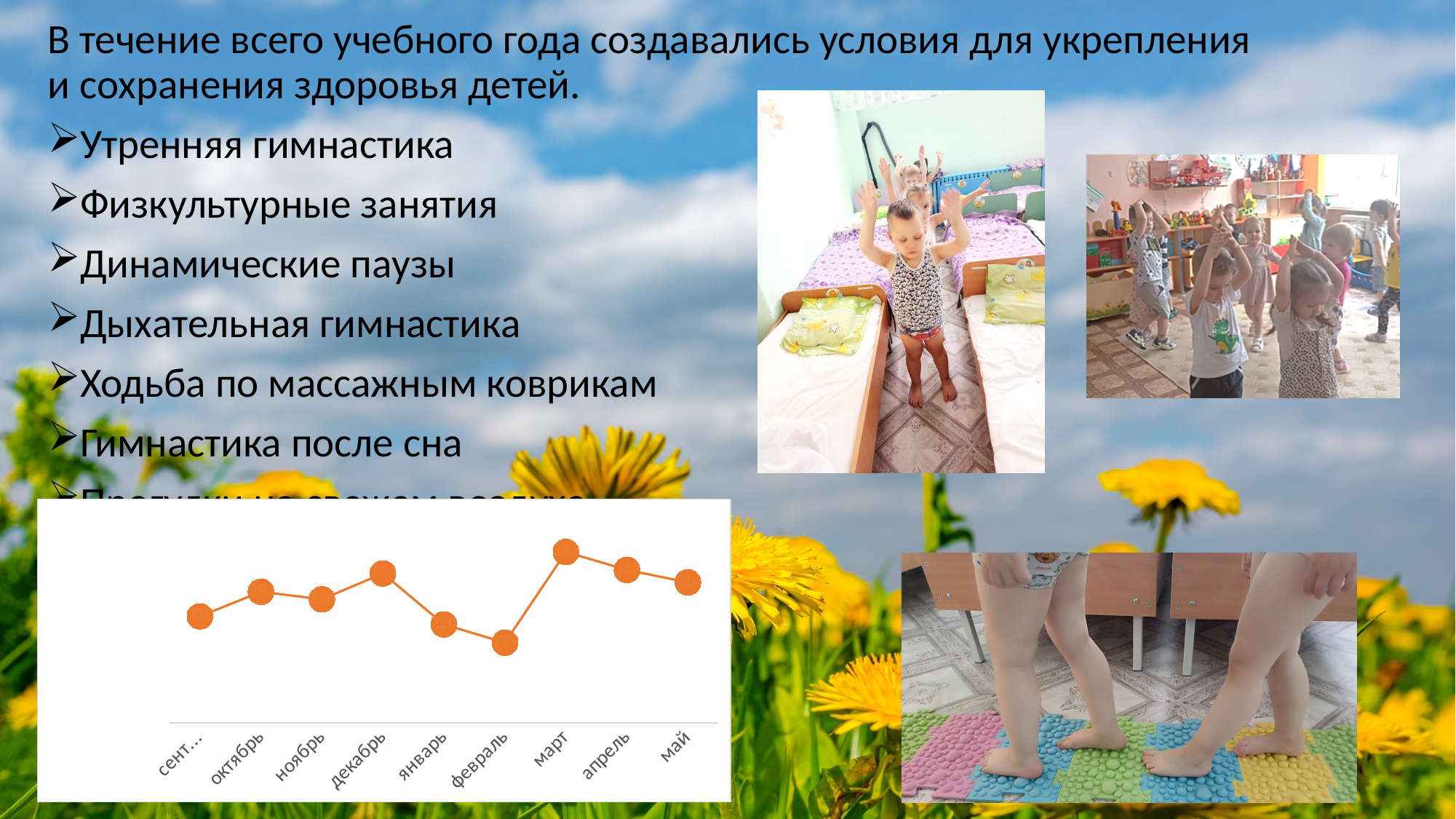
Which month has the lowest value on the line chart? февраль On the line chart, does the value rise or fall from февраль to март? rise On the line chart, which is higher: the value for январь or the value for февраль? январь How many data points are plotted on the line chart? 9 On the line chart, which is higher: the value for март or the value for апрель? март On the line chart, which is higher: the value for декабрь or the value for ноябрь? декабрь On the line chart, does the value rise or fall from март to май? fall What kind of chart is shown at the bottom left of the slide? line chart Which month has the highest value on the line chart? март On the line chart, does the value rise or fall from декабрь to февраль? fall What colour is the line and its markers on the line chart? orange